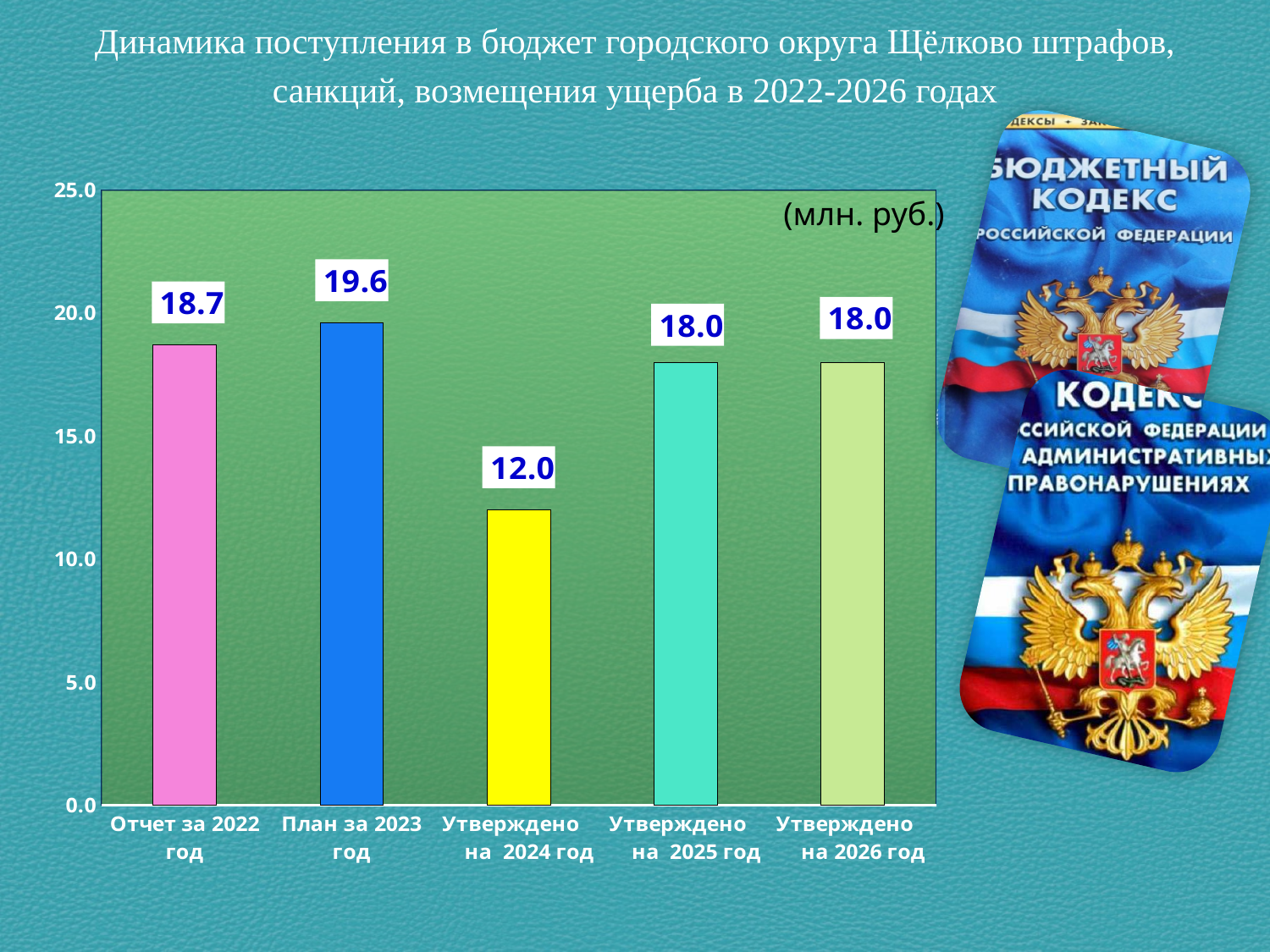
What is the value for "Утверждено на 2024 год"? 12.0 Which category has the lowest value? Утверждено на 2024 год What unit is indicated in the top right corner of the chart area? млн. руб. Which is larger, the value for "Отчет за 2022 год" or the value for "Утверждено на 2025 год"? Отчет за 2022 год What is the difference between the values for "План за 2023 год" and "Утверждено на 2024 год"? 7.6 Is the value for "Утверждено на 2024 год" greater or less than 15.0? less Which category has the highest value? План за 2023 год What is the value for "Отчет за 2022 год"? 18.7 How many bars are shown in the chart? 5 What is the value for "План за 2023 год"? 19.6 What is the value for "Утверждено на 2026 год"? 18.0 What kind of chart is shown on the slide? bar chart